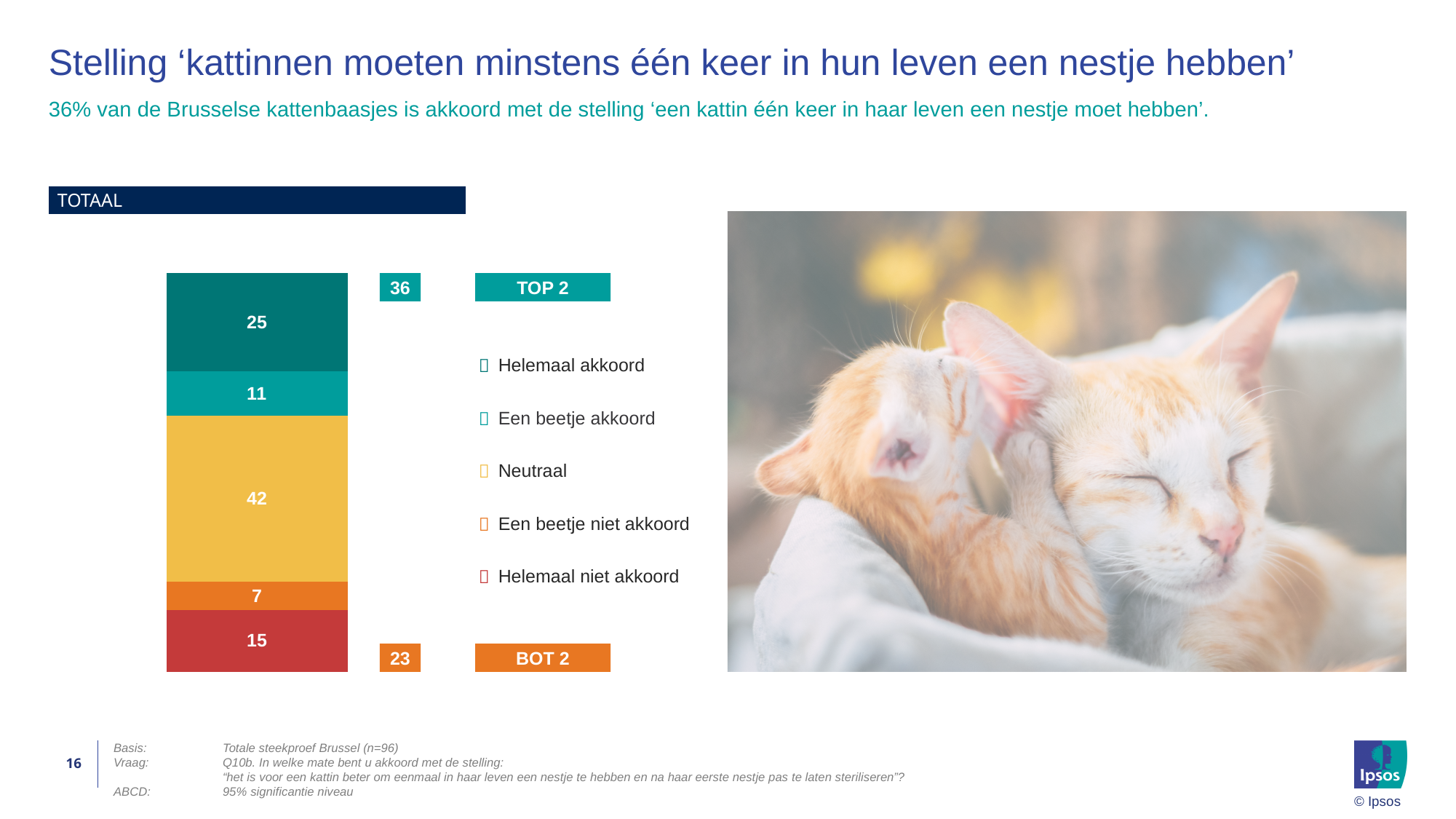
Which response category has the largest segment in the stacked bar? Neutraal What value is shown for 'Een beetje niet akkoord' in the stacked bar? 7 How many response categories does the legend list? 5 What value is shown for 'Helemaal akkoord' in the stacked bar? 25 What value is shown for 'Neutraal' in the stacked bar? 42 Which is larger: the value for 'Helemaal niet akkoord' or the value for 'Een beetje akkoord'? Helemaal niet akkoord What is the BOT 2 value shown next to the bar? 23 What is the difference between the 'Helemaal akkoord' and 'Een beetje akkoord' values? 14 What value is shown for 'Helemaal niet akkoord' in the stacked bar? 15 What type of chart is shown on the slide? Stacked bar chart Which response category has the smallest segment in the stacked bar? Een beetje niet akkoord What is the TOP 2 value shown next to the bar? 36